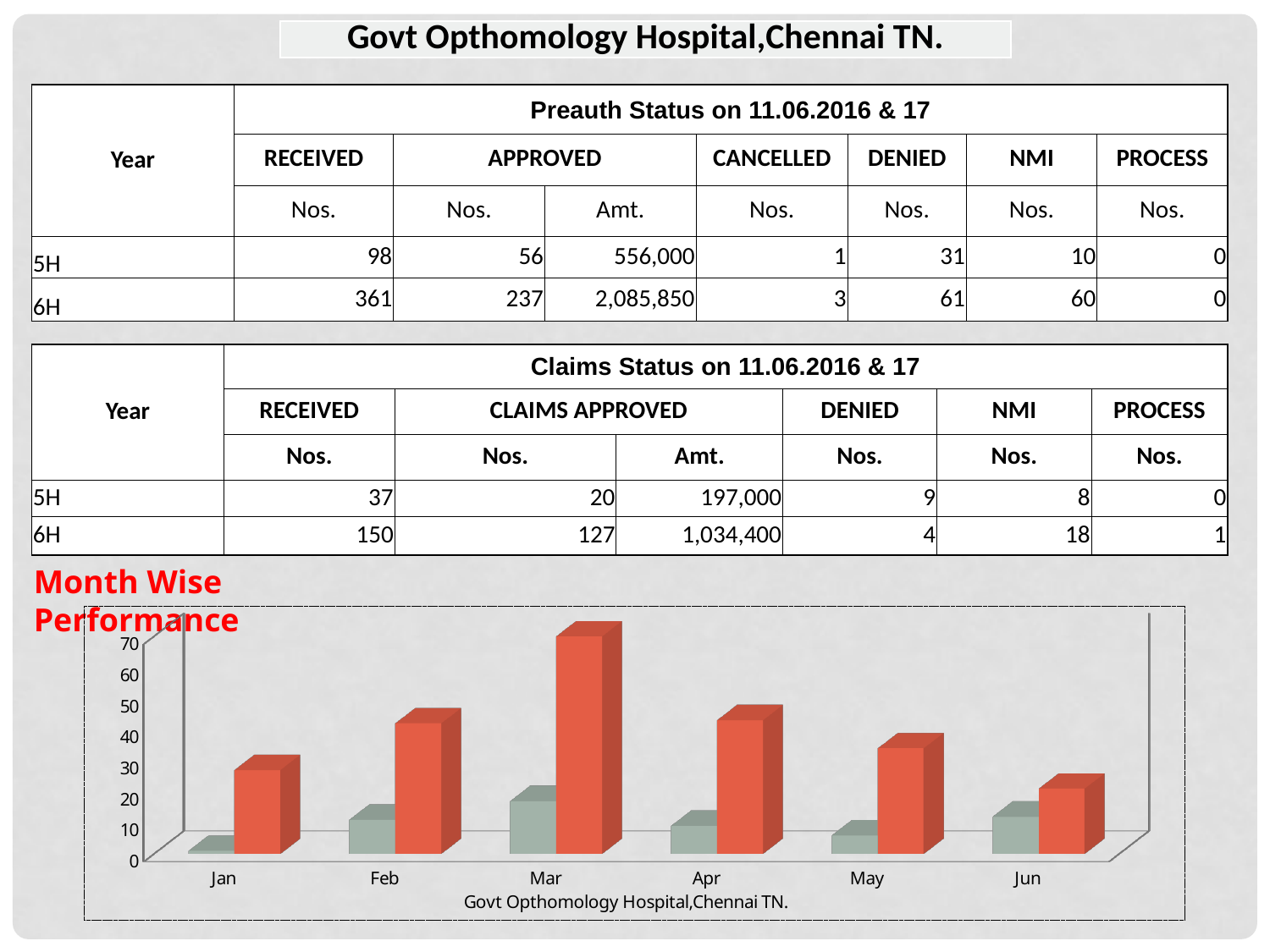
What kind of chart is shown under the heading 'Month Wise Performance'? bar chart In the Month Wise Performance chart, which month has the tallest red bar? Mar In the Month Wise Performance chart, is the red bar for May or the red bar for Jun larger? May In the Month Wise Performance chart, is the red bar for Mar greater or less than 60? greater What text appears below the x axis of the Month Wise Performance chart? Govt Opthomology Hospital,Chennai TN. In the Month Wise Performance chart, which month has the tallest grey bar? Mar In the Month Wise Performance chart, which month has the shortest grey bar? Jan How many months are shown on the x axis of the Month Wise Performance chart? 6 In the Month Wise Performance chart, is the red bar for Jun greater or less than 30? less In the Month Wise Performance chart, is the red bar for Mar or the red bar for Apr larger? Mar In the Month Wise Performance chart, which month has the shortest red bar? Jun In the Month Wise Performance chart, is the grey bar for Mar greater or less than 10? greater